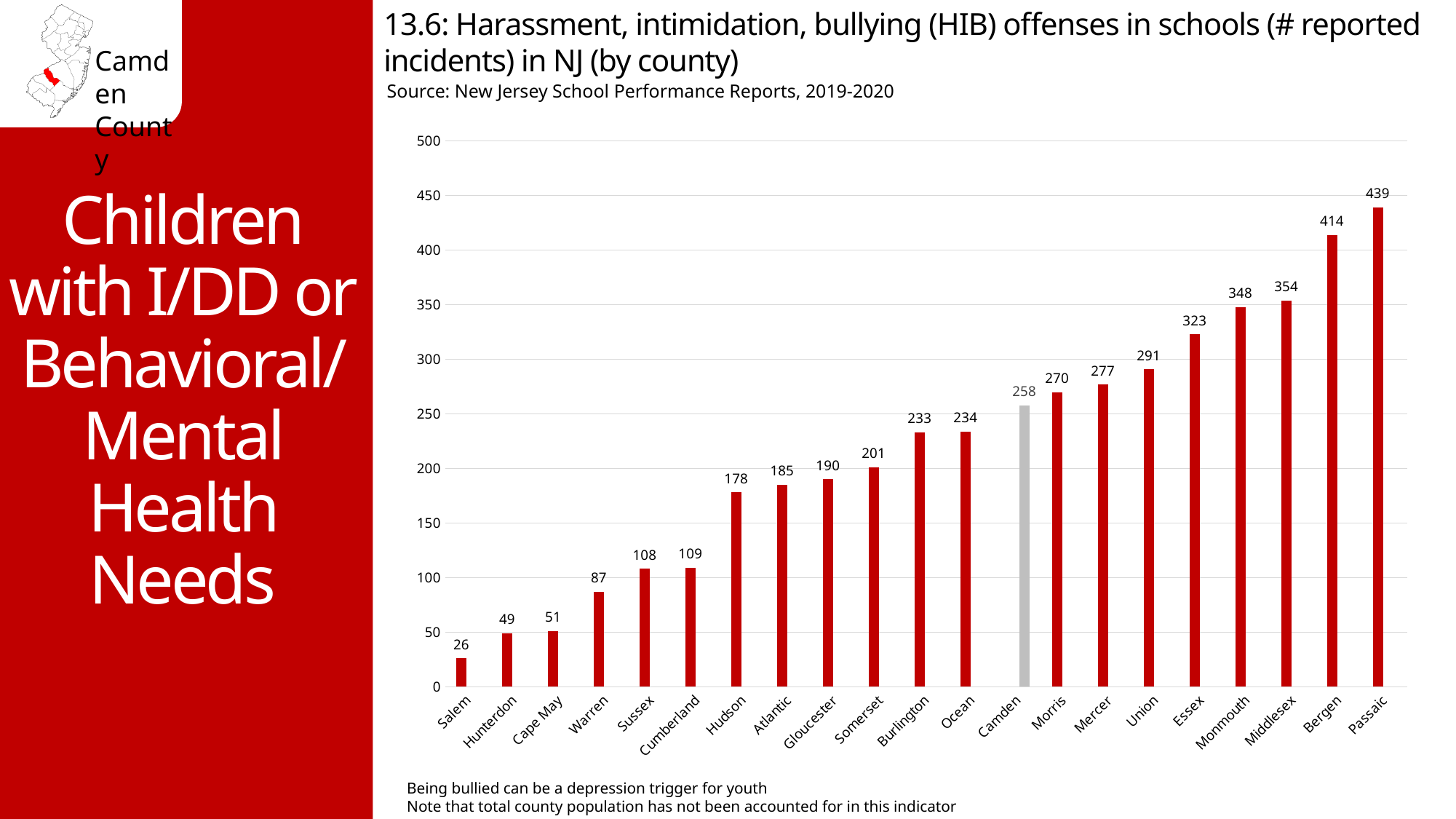
Which county's bar is shown in gray instead of red? Camden Is the value for Monmouth greater or less than 300? greater Do the values rise or fall moving from left to right along the x axis? Rise How many counties are shown on the chart? 21 What is the source cited for the chart data? New Jersey School Performance Reports, 2019-2020 Which county has the lowest number of reported HIB incidents? Salem Which county has the highest number of reported HIB incidents? Passaic What is the difference in reported HIB incidents between Passaic and Camden? 181 Which county has more reported HIB incidents, Essex or Union? Essex What is the number of reported HIB incidents for Bergen County? 414 What kind of chart is shown on the slide? Bar chart What is the number of reported HIB incidents for Camden County? 258